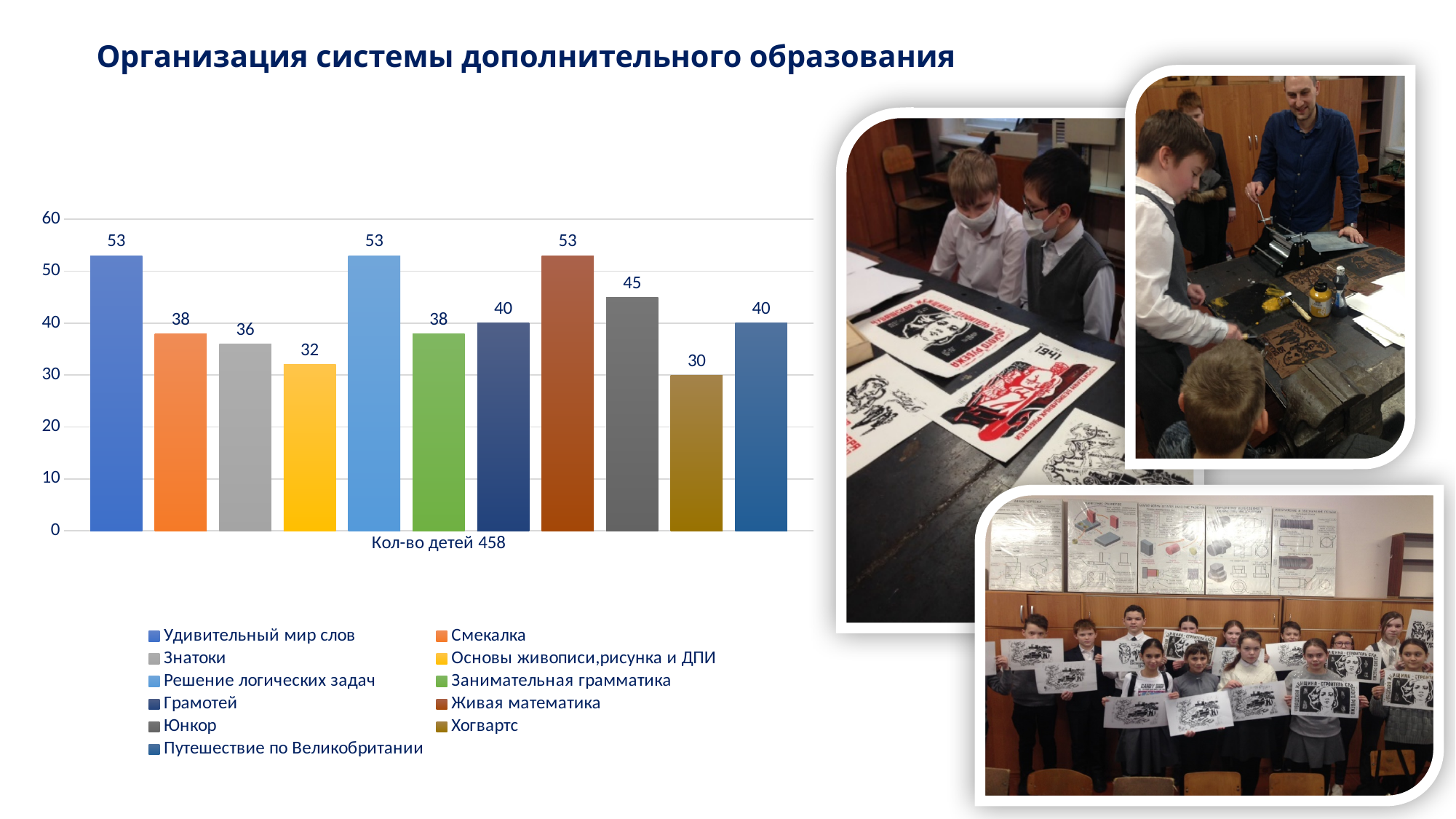
Which is larger, the value for Юнкор or the value for Грамотей? Юнкор What is the value for Основы живописи,рисунка и ДПИ? 32 How many series does the legend list? 11 What is the value for Живая математика? 53 What is the difference between the values for Удивительный мир слов and Знатоки? 17 What is the difference between the values for Юнкор and Хогвартс? 15 What type of chart is shown on the slide? bar chart What is the label shown on the x axis below the bars? Кол-во детей 458 What is the value for Юнкор? 45 What is the value for Смекалка? 38 Which series has the lowest value? Хогвартс What is the value for Путешествие по Великобритании? 40